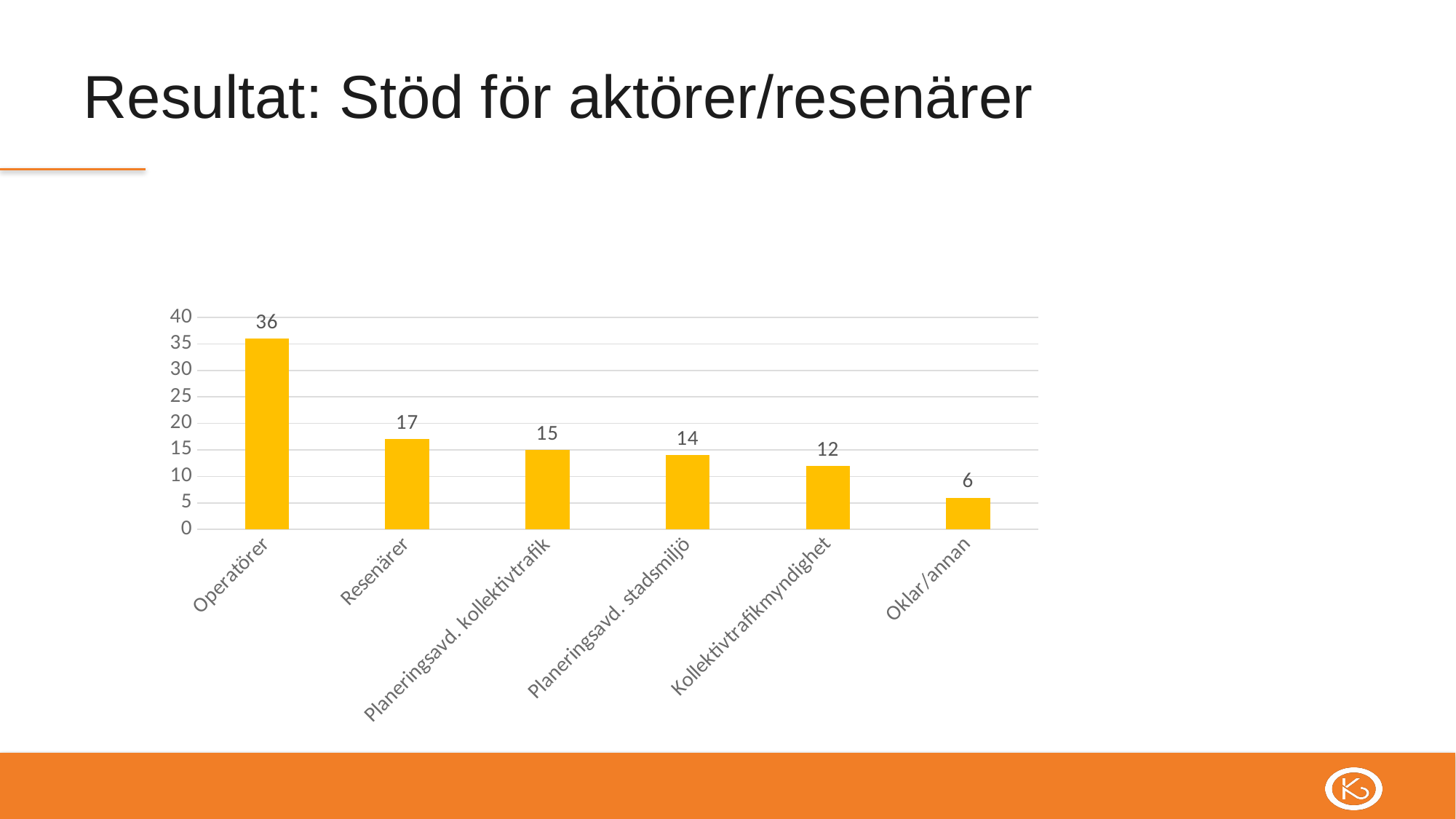
What is the value for Operatörer? 36 What is the value for Planeringsavd. kollektivtrafik? 15 What is the difference between the values for Planeringsavd. stadsmiljö and Oklar/annan? 8 What is the value for Resenärer? 17 What is the value for Kollektivtrafikmyndighet? 12 What kind of chart is shown on the slide? bar chart Which category has the lowest value? Oklar/annan Is the value for Operatörer greater or less than 30? greater How many categories are shown on the x axis? 6 What is the difference between the values for Operatörer and Resenärer? 19 Which category has the highest value? Operatörer Which is larger, the value for Resenärer or the value for Kollektivtrafikmyndighet? Resenärer